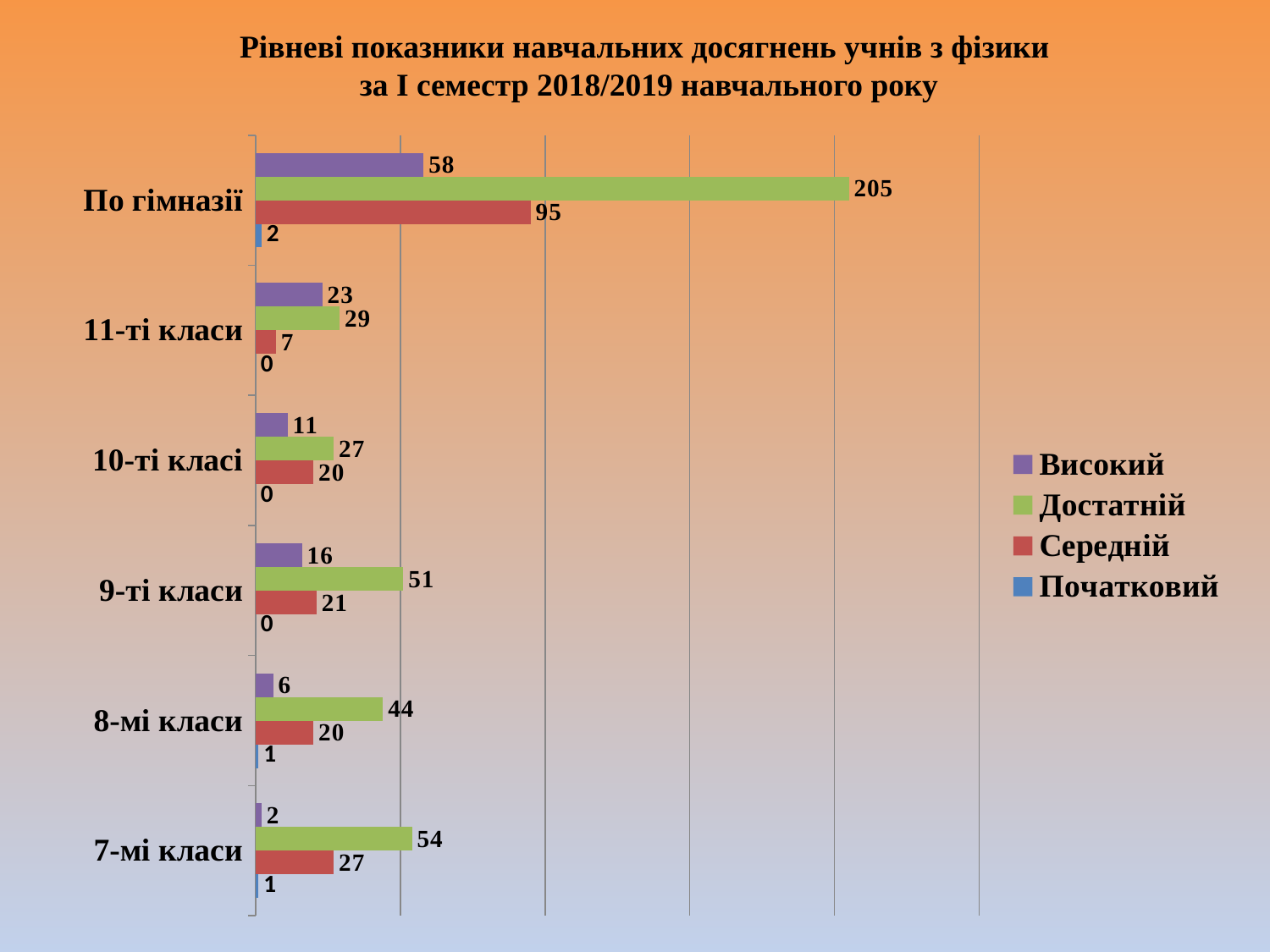
How many categories are shown on the vertical axis? 6 What is the value of Початковий for 8-мі класи? 1 Which is larger for 10-ті класі: Достатній or Середній? Достатній What is the value of Достатній for По гімназії? 205 What is the difference between the Достатній and Середній values for По гімназії? 110 Which series is shown in green in the legend? Достатній Which category has the highest Достатній value? По гімназії What kind of chart is shown on the slide? bar chart How many series does the legend list? 4 What is the value of Високий for 11-ті класи? 23 Among the class categories (excluding По гімназії), which has the lowest Високий value? 7-мі класи What is the value of Середній for 9-ті класи? 21